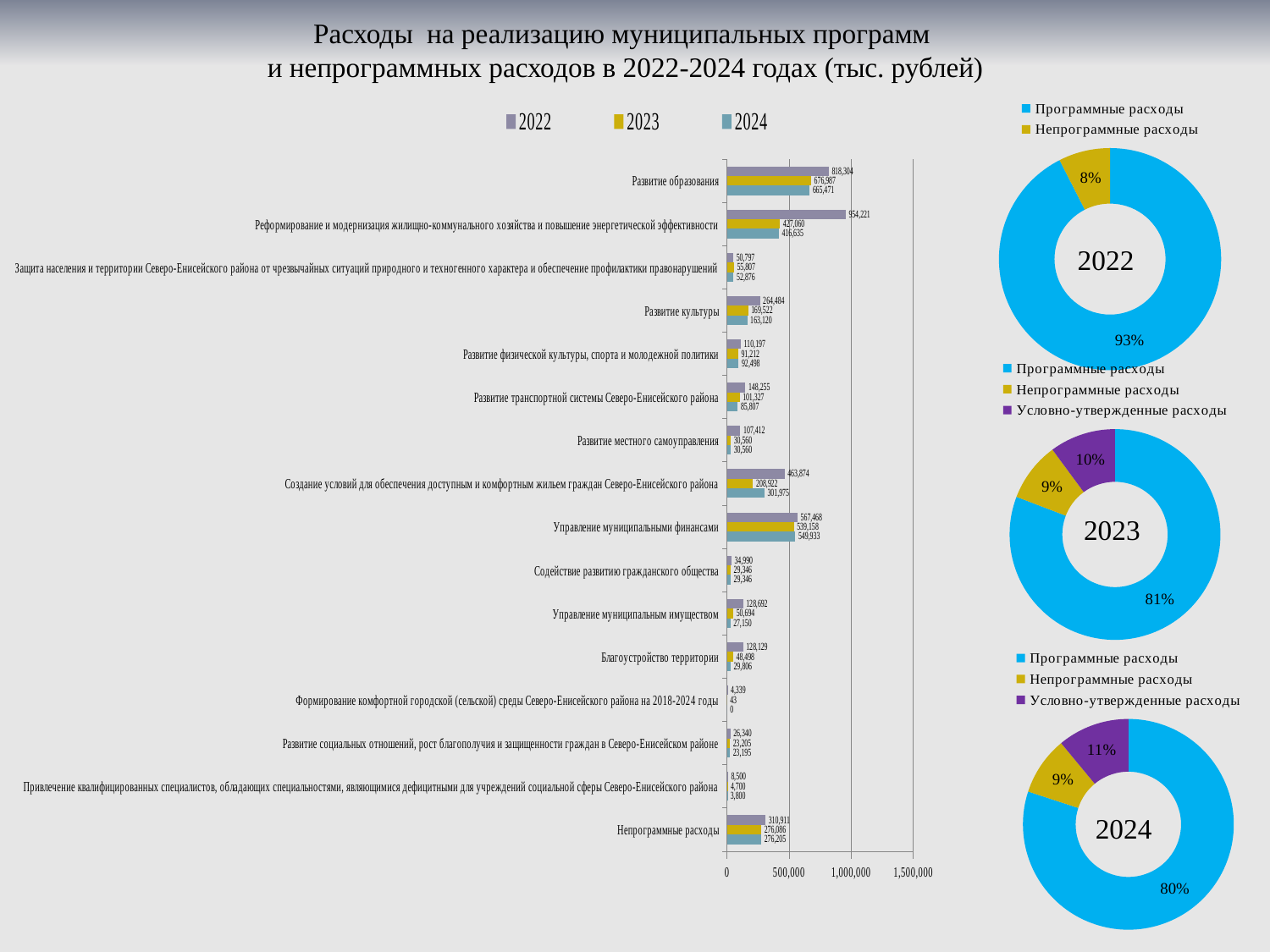
In the 2023 donut chart, what share is Условно-утвержденные расходы? 10% In the bar chart, what is the difference between the 2022 and 2023 values for Развитие образования? 141,317 In the bar chart, what is the 2023 value for Развитие культуры? 169,522 How many series does the bar chart legend list? 3 How many categories are shown on the bar chart? 16 In the bar chart, is the 2022 value for Реформирование и модернизация жилищно-коммунального хозяйства greater or less than 500,000? greater What kind of chart is the large chart on the left of the slide? Bar chart In the bar chart, what is the 2024 value for Управление муниципальными финансами? 549,933 In the bar chart, what is the 2022 value for Развитие образования? 818,304 In the 2024 donut chart, what share is Программные расходы? 80% In the bar chart, which category has the highest 2022 value? Реформирование и модернизация жилищно-коммунального хозяйства и повышение энергетической эффективности In the bar chart, which is larger for Развитие транспортной системы Северо-Енисейского района: the 2023 value or the 2024 value? 2023